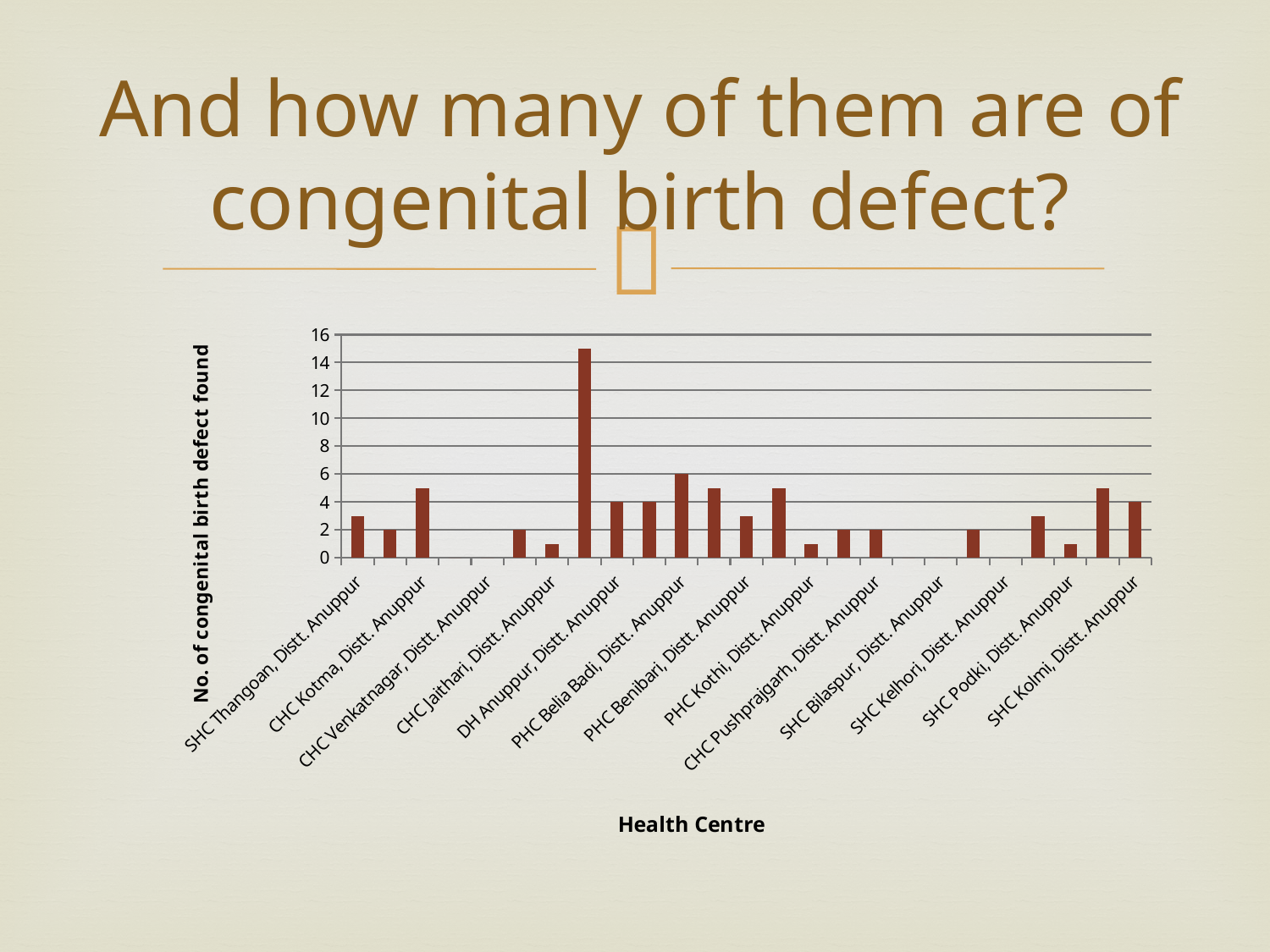
What is the title of the vertical axis of the chart? No. of congenital birth defect found What is the value for SHC Kolmi, Distt. Anuppur? 4 What kind of chart is shown on the slide? bar chart What is the title of the horizontal axis of the chart? Health Centre Is the value for SHC Thangoan, Distt. Anuppur greater or less than 4? less Is the tallest bar in the chart greater or less than 14? greater What is the highest value shown on the vertical axis? 16 Which is larger, the value for SHC Kolmi, Distt. Anuppur or the value for SHC Thangoan, Distt. Anuppur? SHC Kolmi, Distt. Anuppur Is the value for SHC Thangoan, Distt. Anuppur greater or less than 2? greater